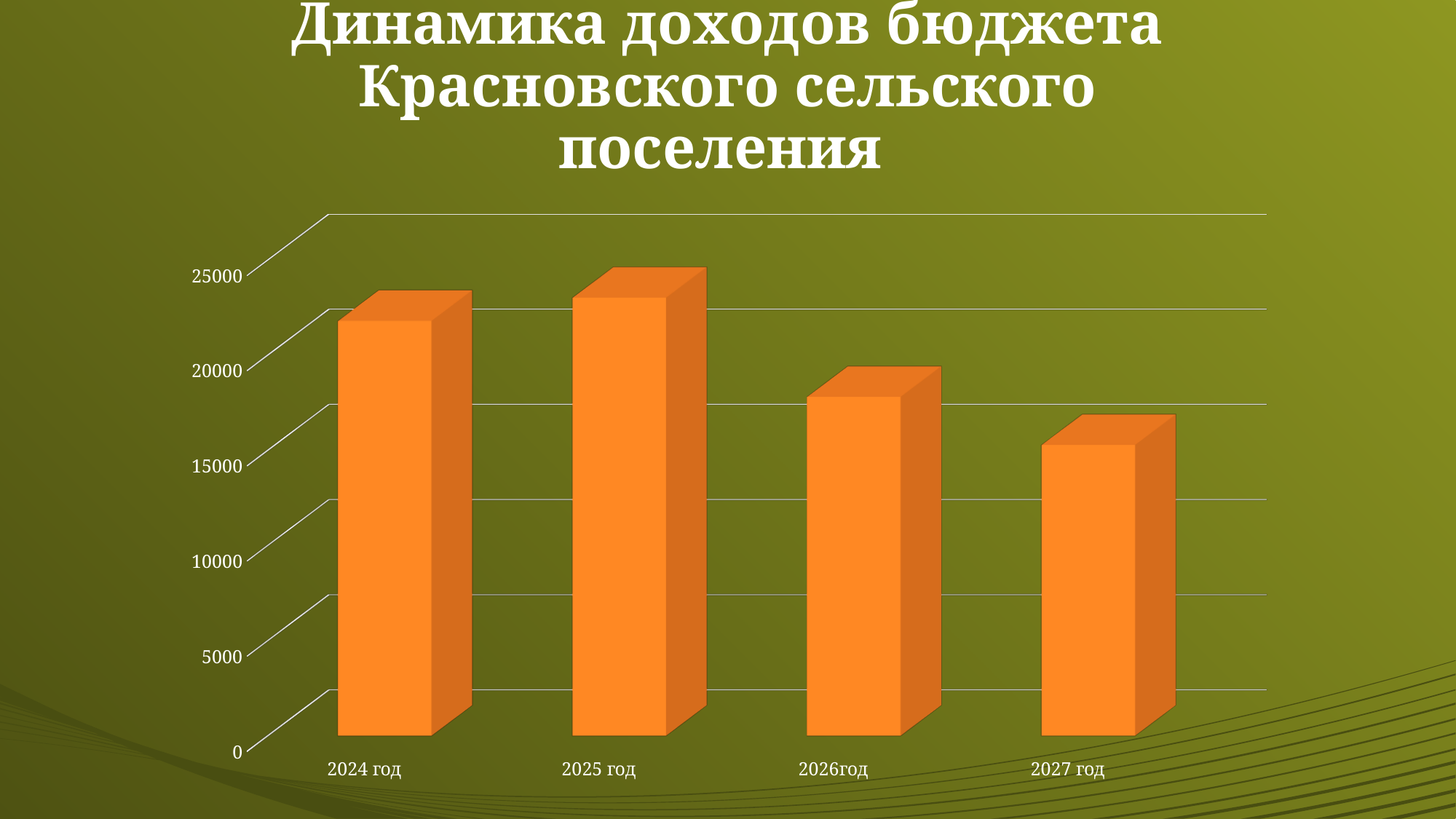
Is the value for 2025 год greater or less than 25000? less What is the title of the chart on the slide? Динамика доходов бюджета Красновского сельского поселения Do the values rise or fall from 2025 год to 2027 год? fall Is the value for 2026год greater or less than 20000? less What kind of chart is shown on the slide? Bar chart How many categories (years) are shown on the x axis of the chart? 4 Which year has the highest budget income in the chart? 2025 год Which is larger, the value for 2026год or the value for 2027 год? 2026год Which year has the lowest budget income in the chart? 2027 год Is the value for 2024 год greater or less than 20000? greater Which is larger, the value for 2024 год or the value for 2025 год? 2025 год